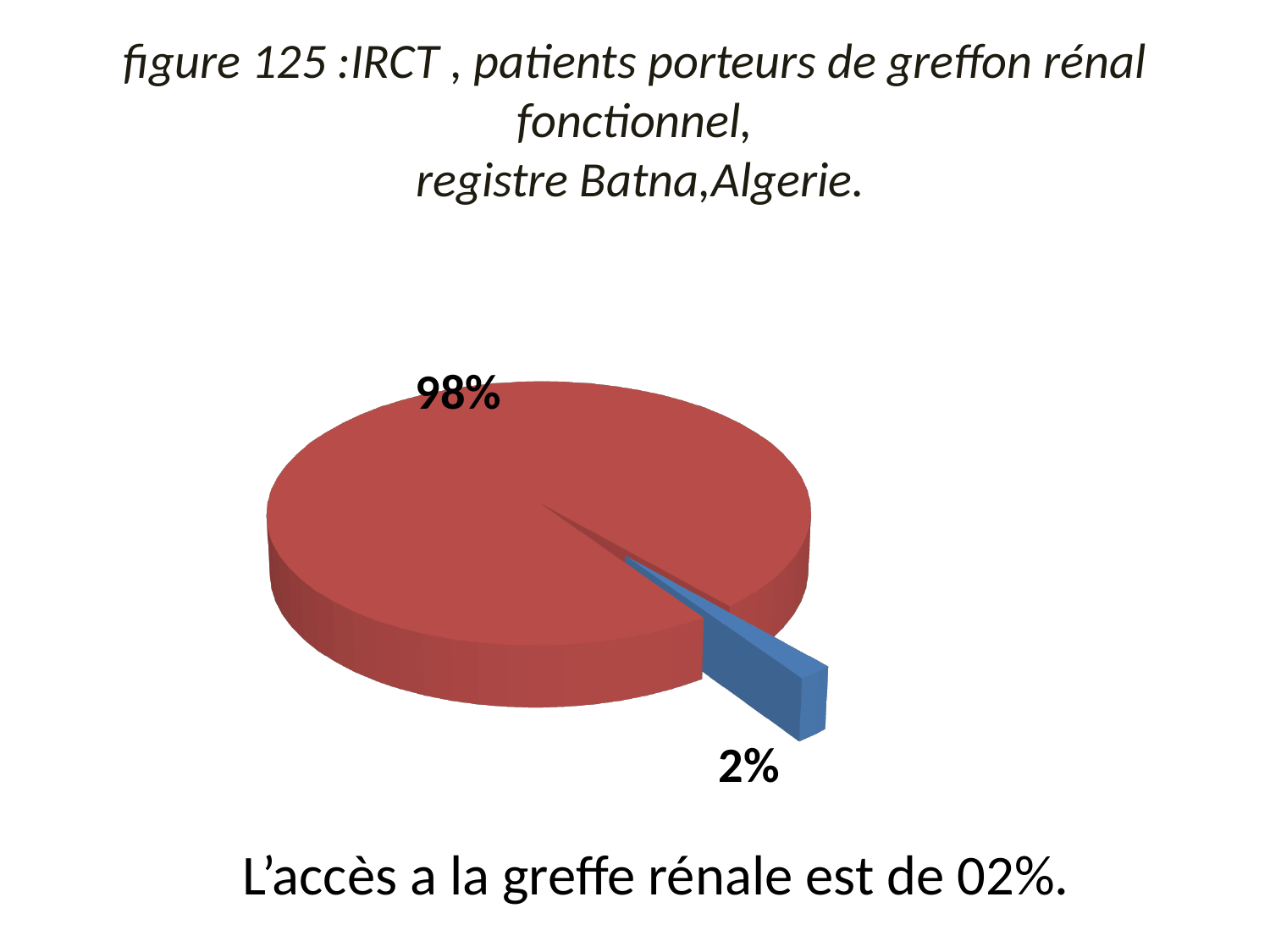
What colour is the slice labelled 2%? blue How many slices does the pie chart have? 2 What is the difference in percentage points between the red slice and the blue slice? 96 What is the figure number given in the chart title? figure 125 Which slice of the pie chart is the smallest? the blue slice (2%) Is the value of the red slice greater or less than 50%? greater Which is larger, the red slice or the blue slice? the red slice What share of the pie does the red slice represent? 98% Which slice of the pie chart is the largest? the red slice (98%) What share of the pie does the blue slice represent? 2% What kind of chart is shown on the slide? pie chart